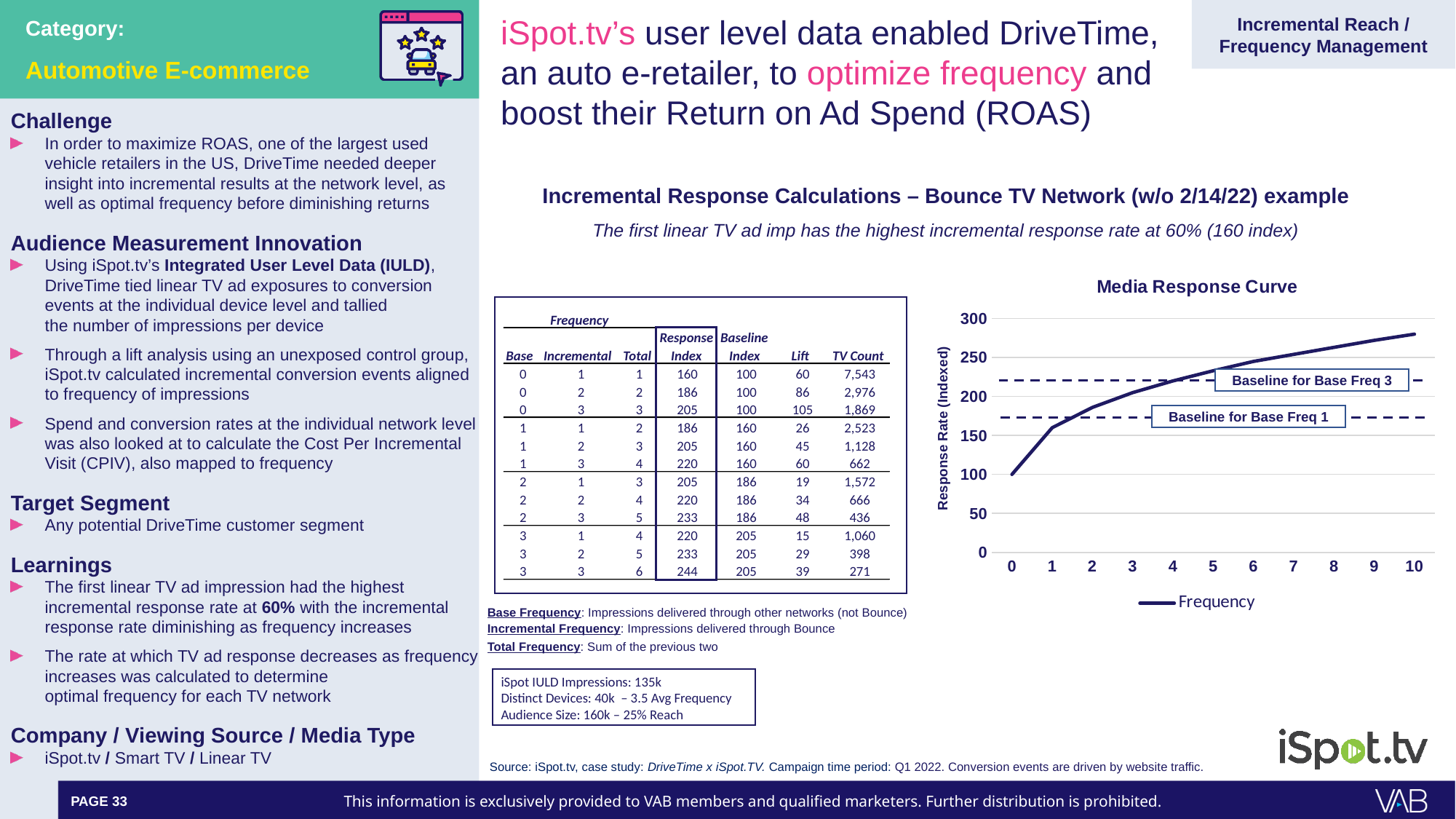
In the Media Response Curve chart, does the response rate rise or fall as frequency increases along the x axis? rise In the Media Response Curve chart, which frequency has the lowest response rate? 0 In the Media Response Curve chart, how many series does the legend list? 1 In the Media Response Curve chart, is the value at frequency 5 greater or less than 200? greater In the Media Response Curve chart, is the value at frequency 2 greater or less than 150? greater What kind of chart is the Media Response Curve? line chart In the Media Response Curve chart, how many frequency values are marked on the x axis? 11 In the Media Response Curve chart, which frequency has the highest response rate? 10 In the Media Response Curve chart, what is the label on the y axis? Response Rate (Indexed) In the Media Response Curve chart, is the value at frequency 1 greater or less than 200? less What is the title of the chart on the right side of the slide? Media Response Curve